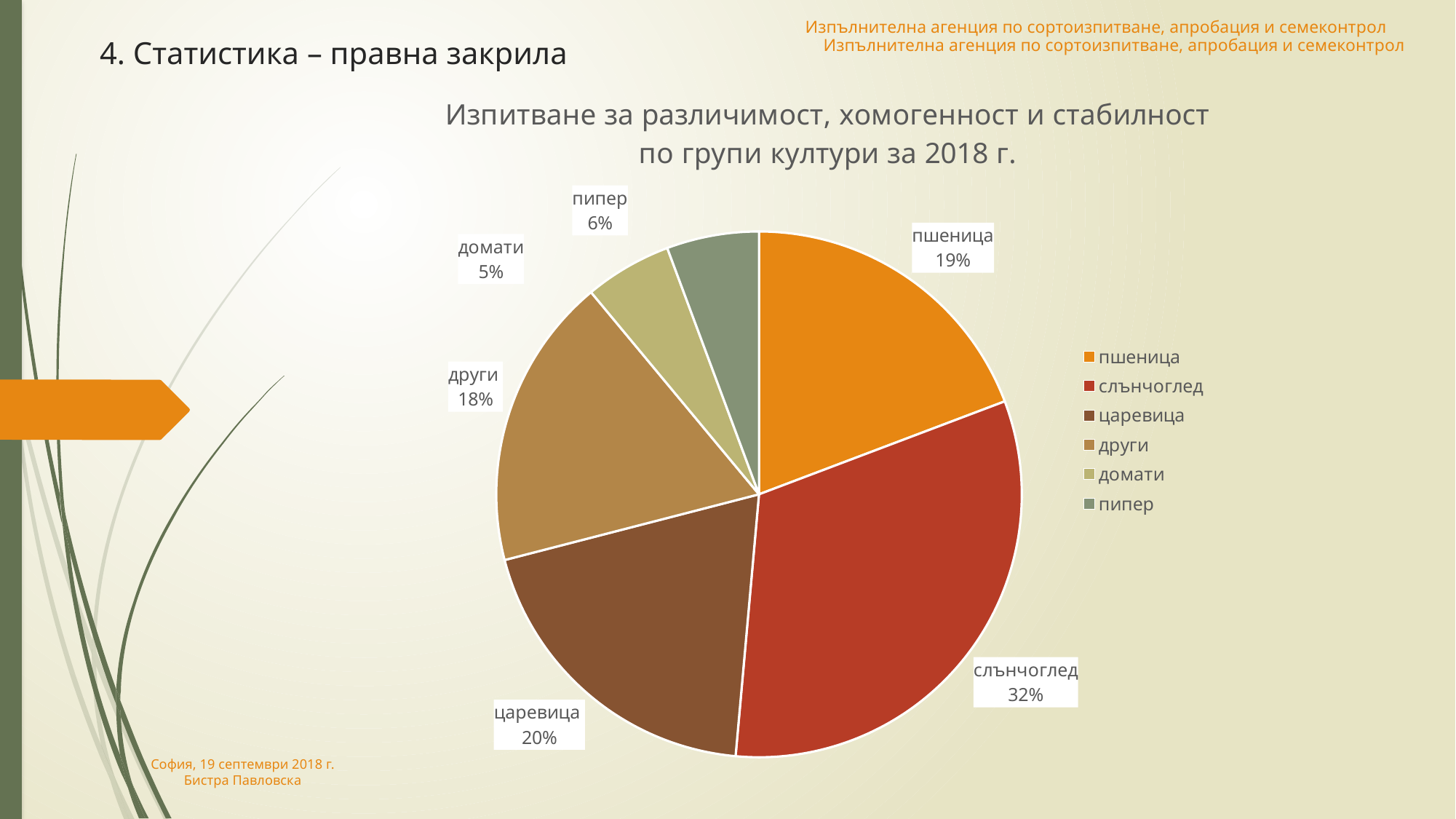
What share of the pie does слънчоглед have? 32% Which category has the largest slice of the pie? слънчоглед What is the value shown for домати? 5% What is the value shown for пшеница? 19% What is the value shown for царевица? 20% Which category has the smallest slice of the pie? домати What is the title of the chart? Изпитване за различимост, хомогенност и стабилност по групи култури за 2018 г. What kind of chart is shown on the slide? pie chart What colour is the slice for пшеница? orange What is the difference in percentage points between слънчоглед and царевица? 12 Which is larger, the share for други or the share for пипер? други How many categories are shown in the pie chart? 6